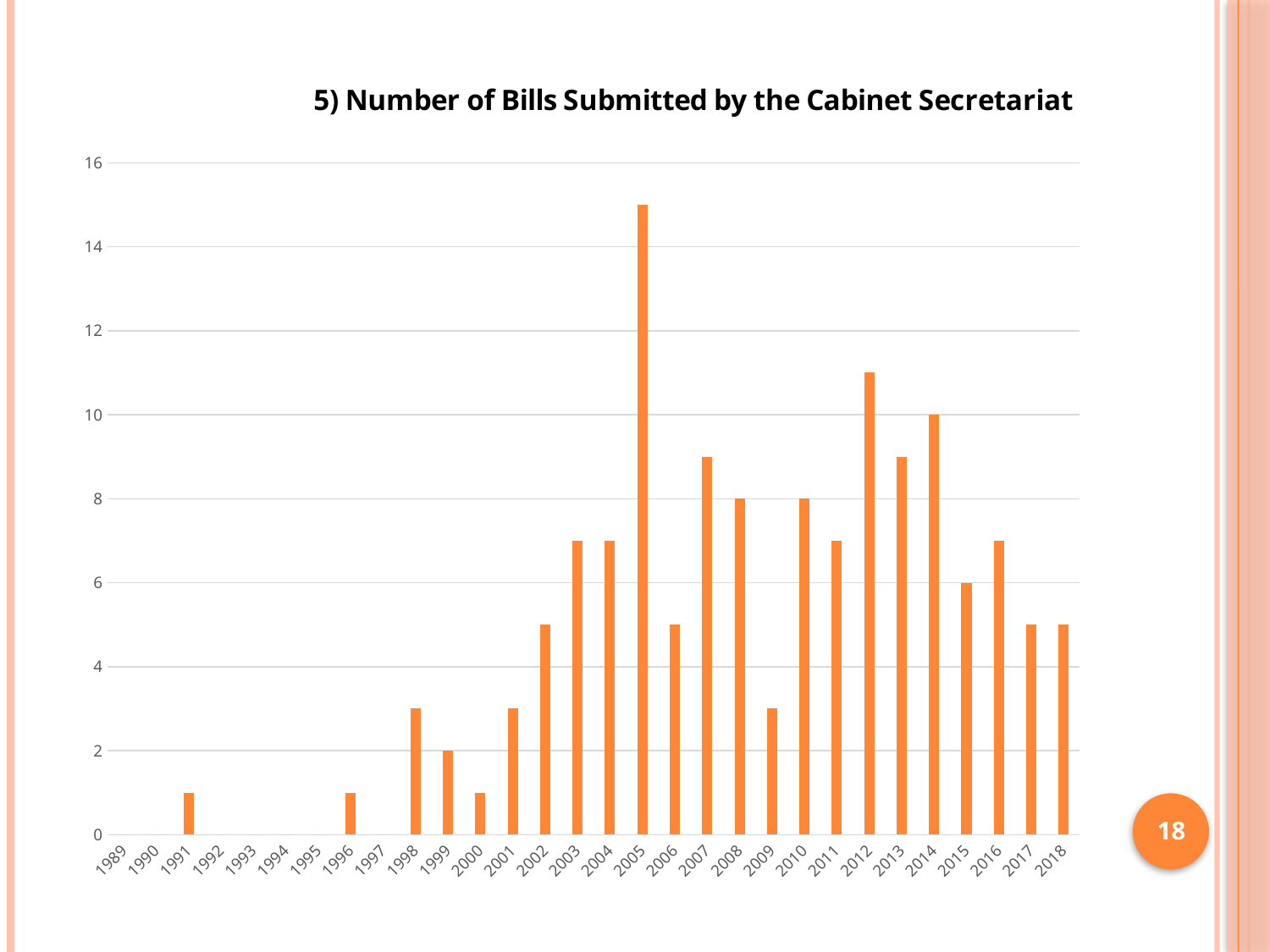
Which year has the highest number of bills submitted? 2005 What is the title of the chart? 5) Number of Bills Submitted by the Cabinet Secretariat What is the number of bills submitted in 2014? 10 Is the value for 2009 greater or less than 4? less What is the difference between the values for 2014 and 2010? 2 Do the values rise or fall from 2001 to 2005? rise Is the value for 2005 greater or less than 14? greater What is the number of bills submitted in 1999? 2 Which is larger, the value for 2007 or the value for 2006? 2007 How many years are shown on the x axis of the chart? 30 What is the number of bills submitted in 2015? 6 What kind of chart is shown on the slide? bar chart